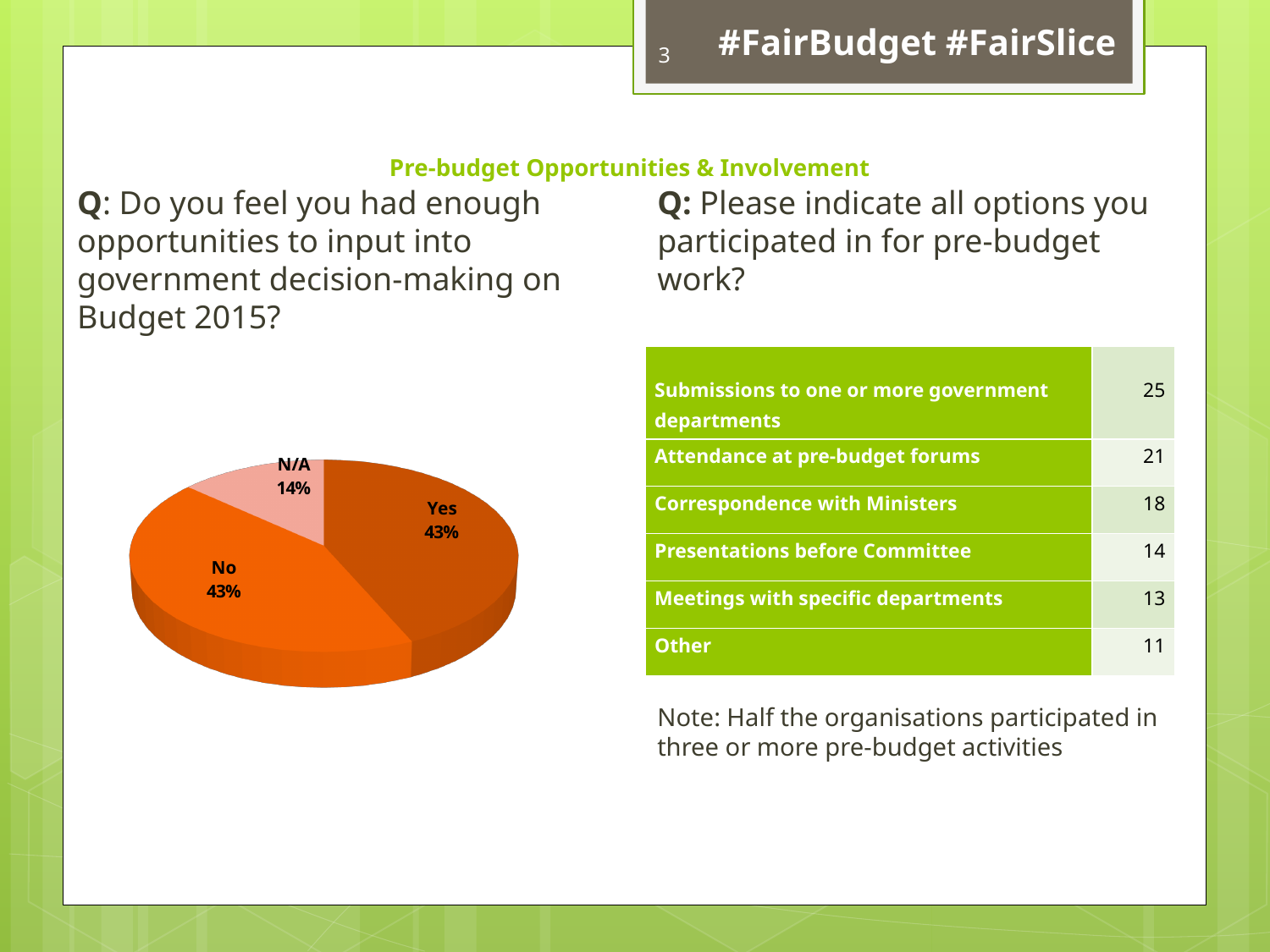
Which slice of the pie chart is the smallest? N/A In the pie chart, which is larger, the "Yes" slice or the "N/A" slice? Yes What share of the pie chart is labelled "No"? 43% What is the difference in percentage points between the "Yes" slice and the "N/A" slice in the pie chart? 29% What kind of chart is shown on the left of the slide? pie chart What is the difference in percentage points between the "No" slice and the "N/A" slice in the pie chart? 29% What share of the pie chart is labelled "Yes"? 43% How many slices does the pie chart have? 3 What is the combined share of the "Yes" and "No" slices in the pie chart? 86% What are the labels of the three slices in the pie chart? Yes, No, N/A What share of the pie chart is labelled "N/A"? 14% In the pie chart, which is larger, the "No" slice or the "N/A" slice? No